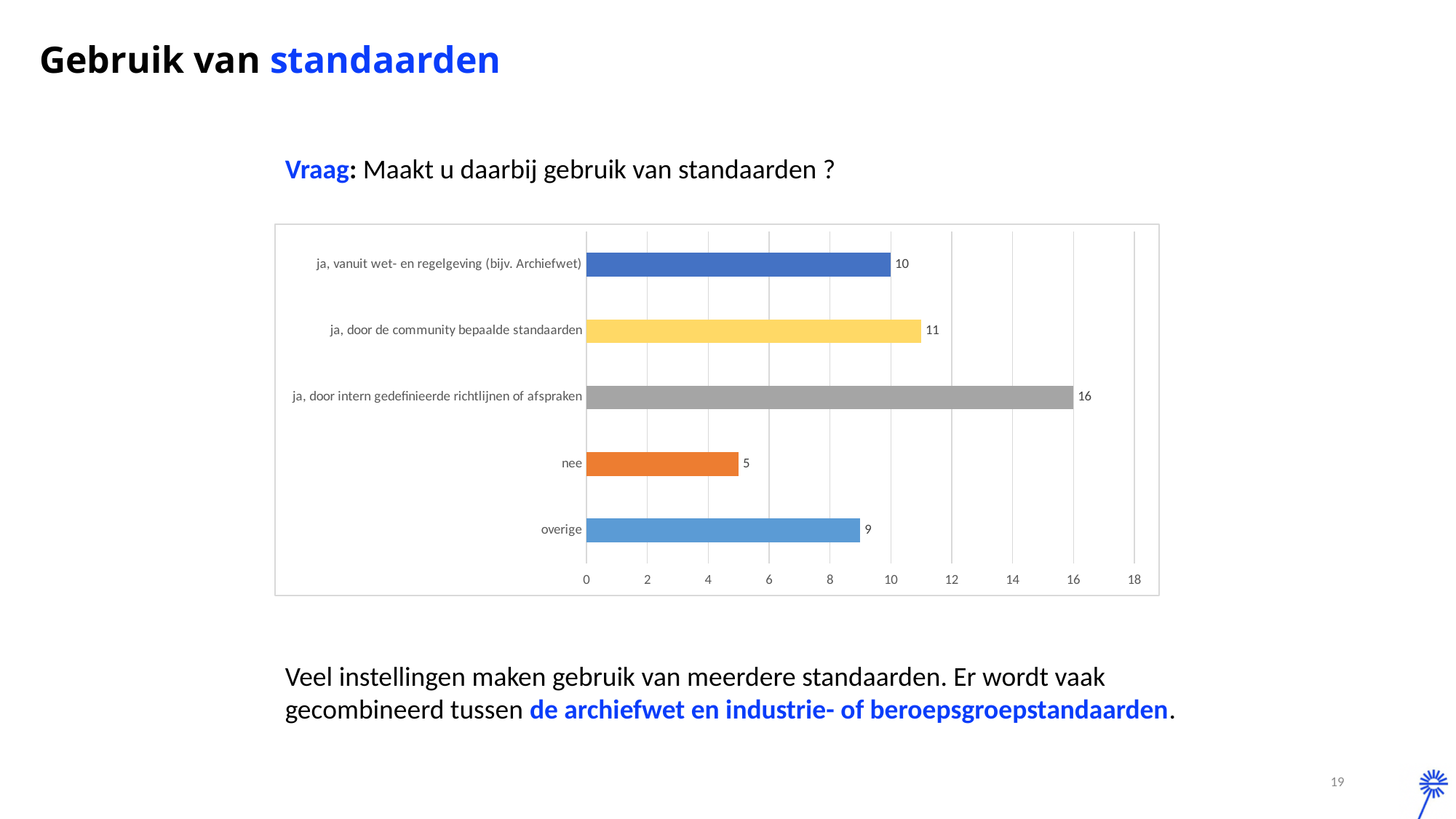
Which is larger: the value for "ja, door de community bepaalde standaarden" or the value for "overige"? ja, door de community bepaalde standaarden Which category has the lowest value? nee What is the value for "ja, door de community bepaalde standaarden"? 11 What is the value for "nee"? 5 Which category has the highest value? ja, door intern gedefinieerde richtlijnen of afspraken What is the value for "overige"? 9 What colour is the bar for "nee"? orange How many categories are shown in the chart? 5 What is the value for "ja, vanuit wet- en regelgeving (bijv. Archiefwet)"? 10 What kind of chart is shown on the slide? bar chart Is the value for "ja, door intern gedefinieerde richtlijnen of afspraken" greater or less than 14? greater What is the difference between the values for "ja, door intern gedefinieerde richtlijnen of afspraken" and "nee"? 11